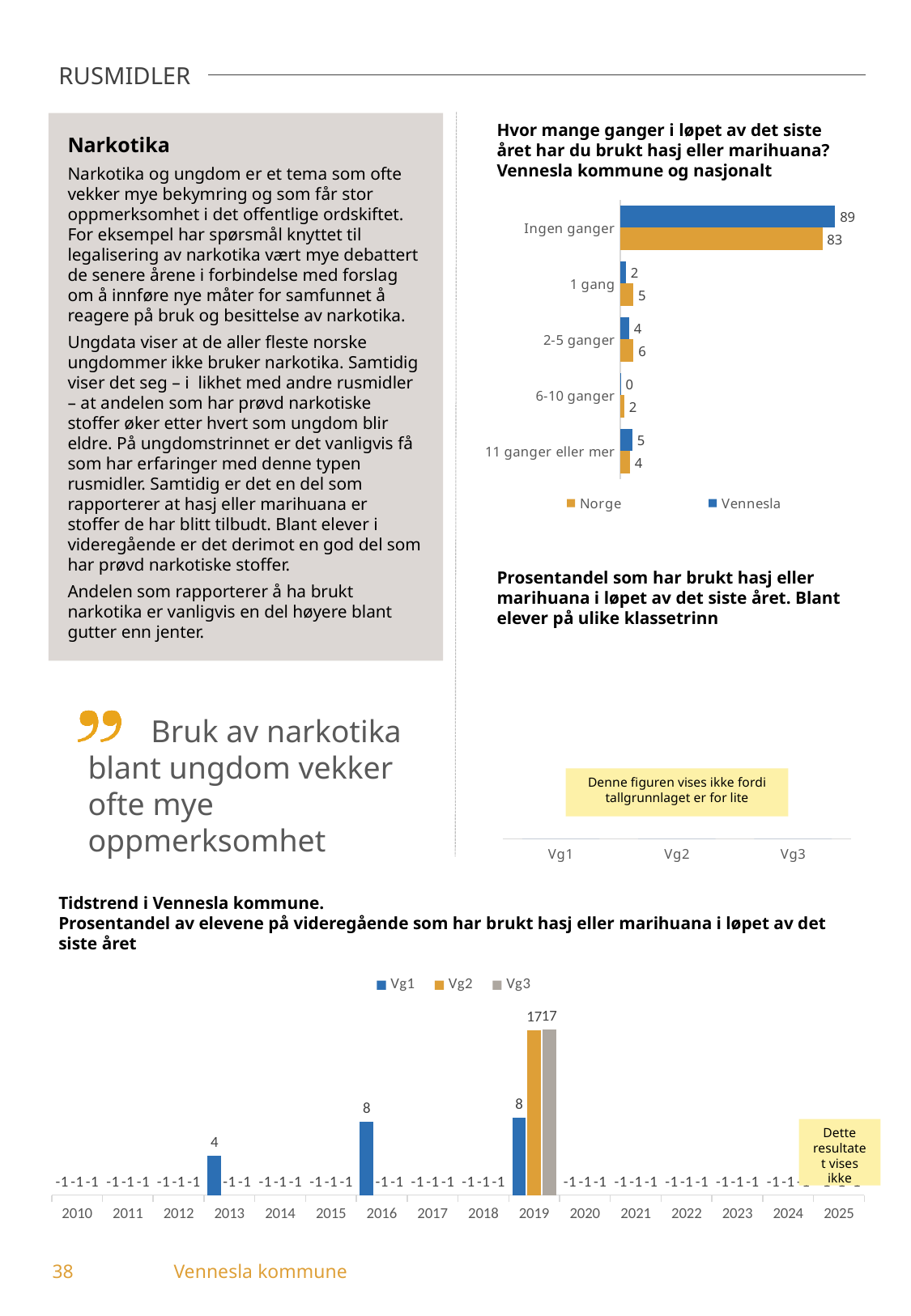
In the chart 'Tidstrend i Vennesla kommune', what is the value for Vg1 in 2013? 4 How many series does the legend list in the chart 'Hvor mange ganger i løpet av det siste året har du brukt hasj eller marihuana?'? 2 In the chart 'Hvor mange ganger i løpet av det siste året har du brukt hasj eller marihuana?', which is larger for '11 ganger eller mer', Norge or Vennesla? Vennesla In the chart 'Hvor mange ganger i løpet av det siste året har du brukt hasj eller marihuana?', what is the difference between Vennesla and Norge for 'Ingen ganger'? 6 What kind of chart is 'Hvor mange ganger i løpet av det siste året har du brukt hasj eller marihuana?'? Bar chart In the chart 'Hvor mange ganger i løpet av det siste året har du brukt hasj eller marihuana?', what is the value for Vennesla for 'Ingen ganger'? 89 In the chart 'Tidstrend i Vennesla kommune', what is the value for Vg2 in 2019? 17 How many series does the legend list in the chart 'Tidstrend i Vennesla kommune'? 3 In the chart 'Hvor mange ganger i løpet av det siste året har du brukt hasj eller marihuana?', what is the value for Norge for '1 gang'? 5 In the chart 'Hvor mange ganger i løpet av det siste året har du brukt hasj eller marihuana?', which category has the lowest value for Vennesla? 6-10 ganger How many categories are shown in the chart 'Hvor mange ganger i løpet av det siste året har du brukt hasj eller marihuana?'? 5 In the chart 'Hvor mange ganger i løpet av det siste året har du brukt hasj eller marihuana?', what is the value for Norge for 'Ingen ganger'? 83